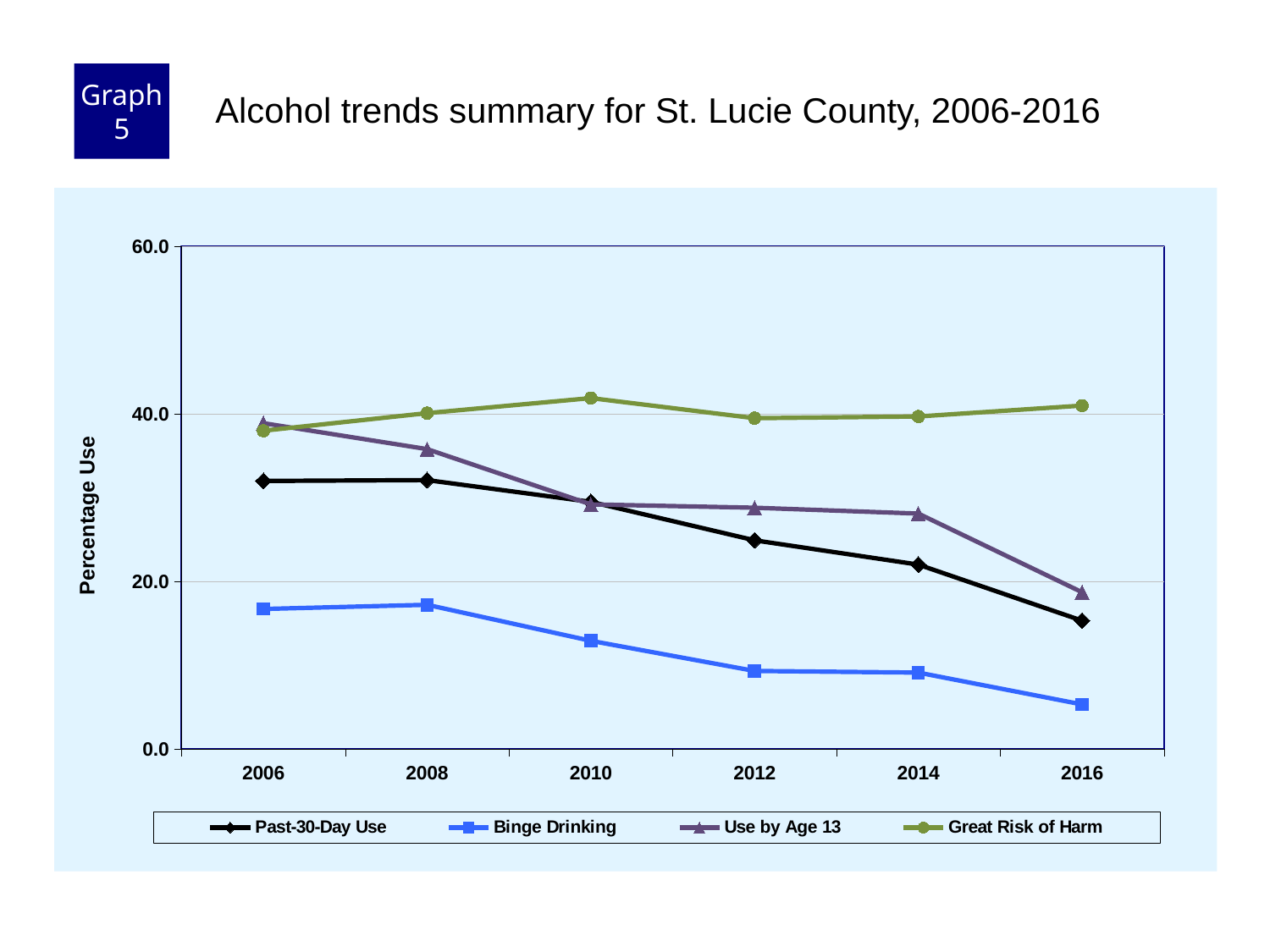
In 2012, which is larger: Past-30-Day Use or Binge Drinking? Past-30-Day Use Is the value for Binge Drinking in 2016 greater or less than 20.0? less Which series has the highest value in 2016? Great Risk of Harm In 2014, which is larger: Great Risk of Harm or Use by Age 13? Great Risk of Harm What is the label on the y axis? Percentage Use How many series does the legend list? 4 Does the Binge Drinking series rise or fall from 2008 to 2016? Fall Which series has the lowest value in 2016? Binge Drinking How many years are plotted along the x axis? 6 Is the value for Past-30-Day Use in 2006 greater or less than 20.0? greater Is the value for Great Risk of Harm in 2012 greater or less than 20.0? greater What kind of chart is shown on the slide? Line chart